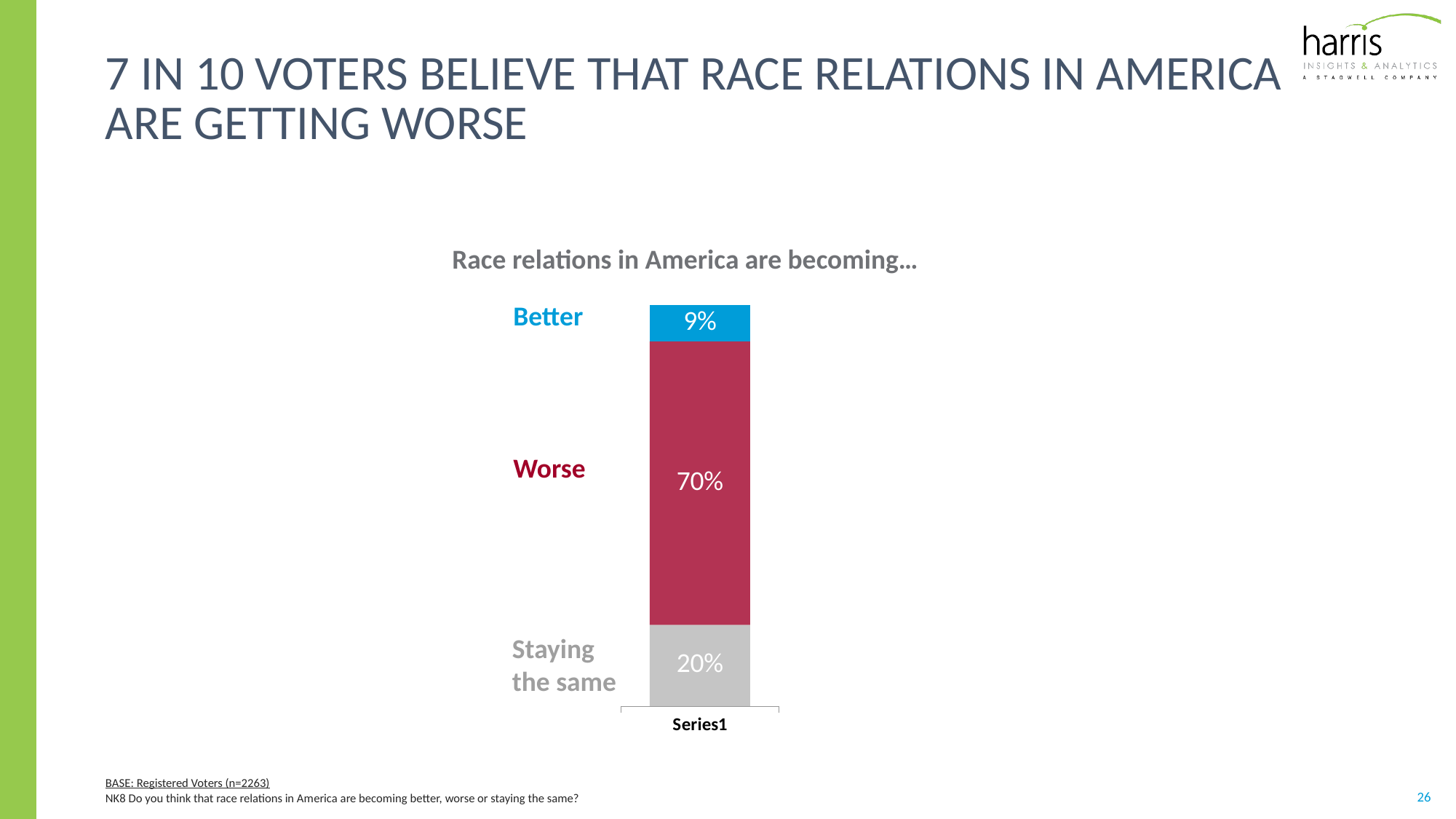
What is the difference between the share saying 'Staying the same' and the share saying 'Better'? 11% What percentage of voters say race relations in America are becoming worse? 70% Which response has the smallest share in the chart? Better What is the total of the three segments in the stacked bar? 99% What percentage of voters say race relations in America are becoming better? 9% How many response categories are shown in the stacked bar? 3 Which is larger: the share saying 'Better' or the share saying 'Staying the same'? Staying the same What is the title of the chart? Race relations in America are becoming… What type of chart is shown on the slide? Stacked bar chart What is the difference between the share saying 'Worse' and the share saying 'Staying the same'? 50% Which response has the largest share in the chart? Worse What percentage of voters say race relations in America are staying the same? 20%